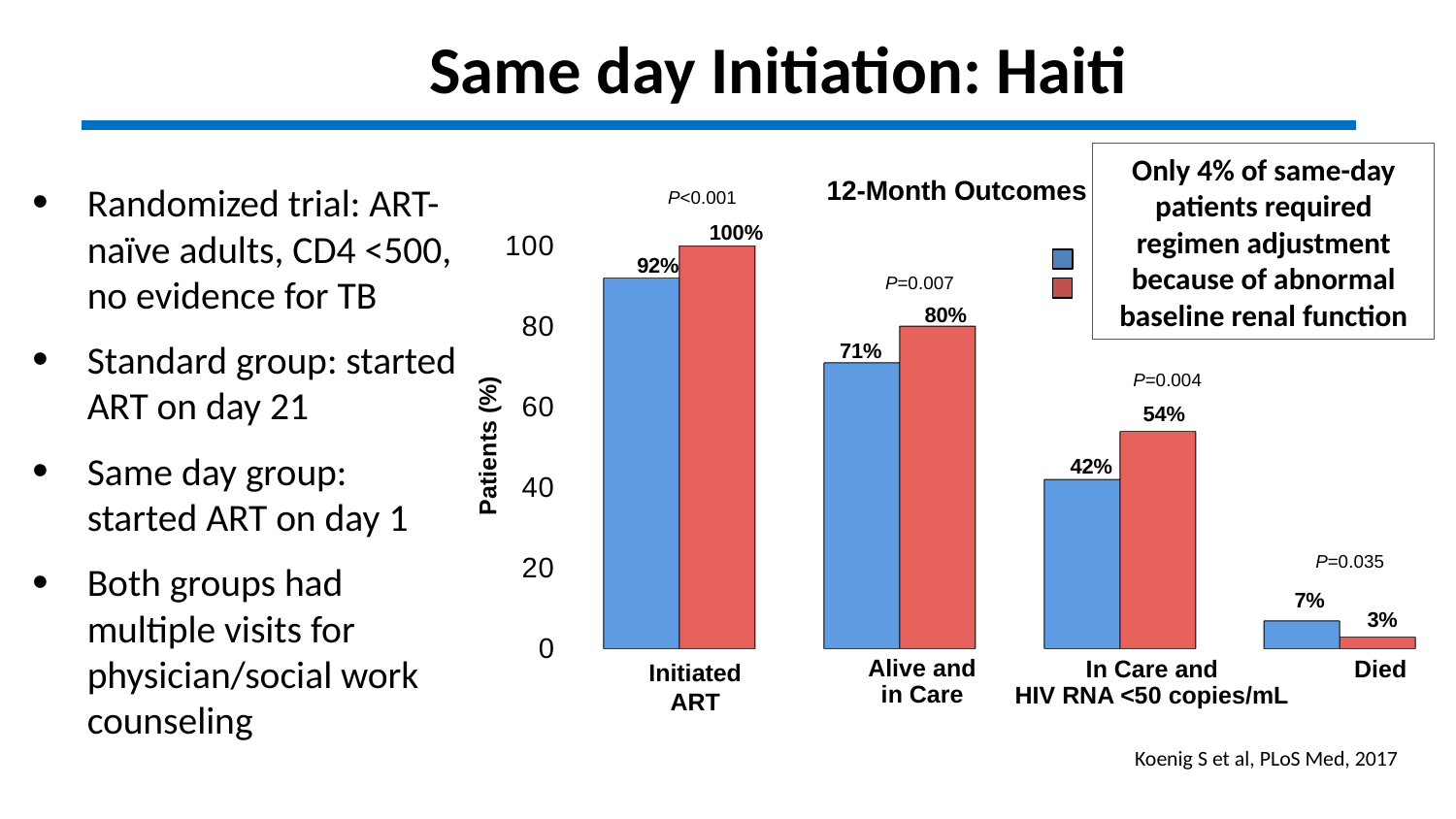
How many outcome categories are shown on the x axis of the chart? 4 What is the value of the blue bar for Alive and in Care? 71% What is the title of the chart? 12-Month Outcomes For the Died category, which bar is larger, the blue bar or the red bar? the blue bar What is the value of the blue bar for Died? 7% What is the value of the red bar for Initiated ART? 100% What kind of chart is shown on the slide? bar chart Which category has the highest value for the blue bars? Initiated ART What is the difference between the red and blue bars for In Care and HIV RNA <50 copies/mL? 12% What is the value of the red bar for In Care and HIV RNA <50 copies/mL? 54% What is the label of the y axis of the chart? Patients (%) Which category has the lowest value for the red bars? Died